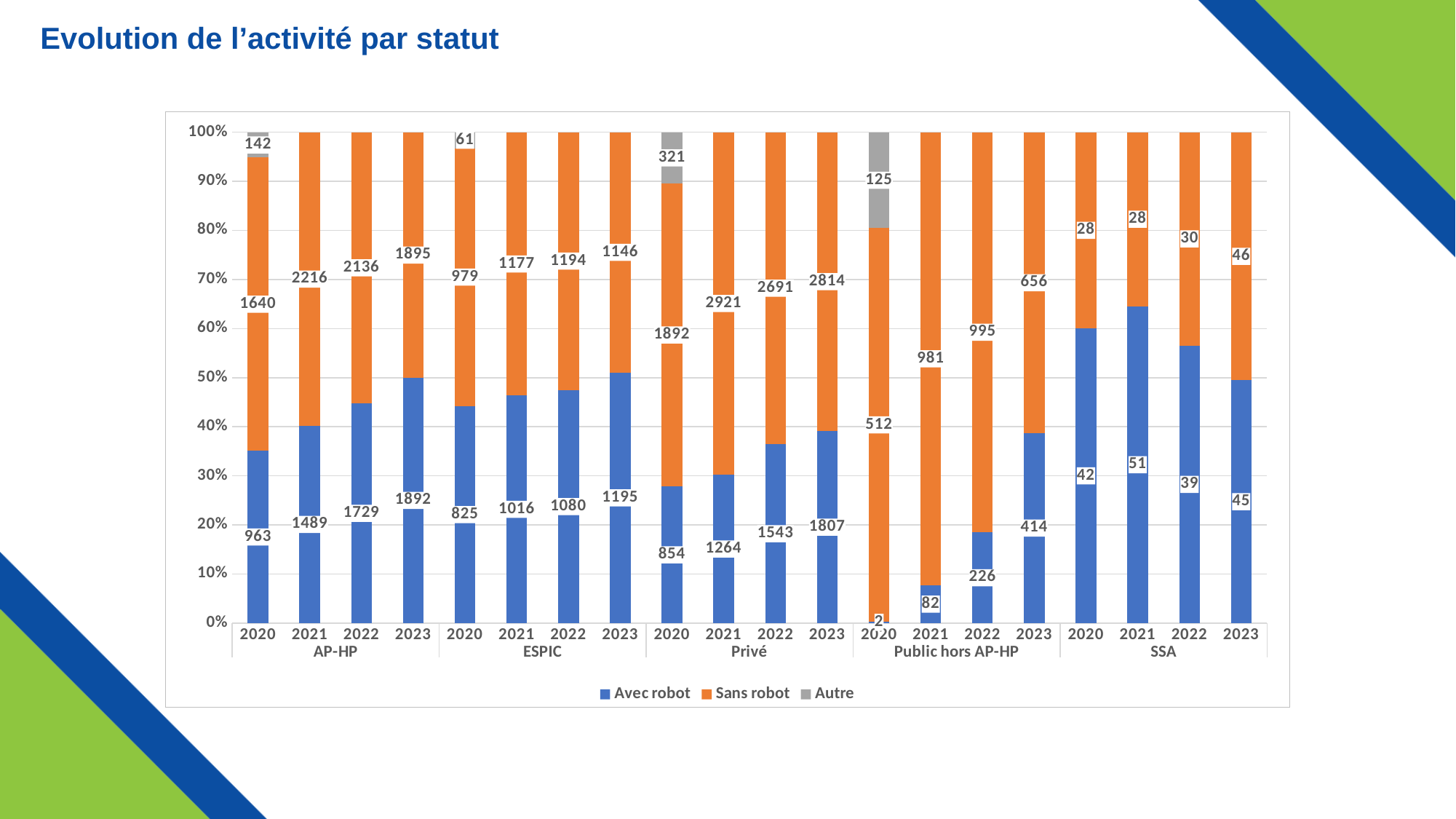
What is the difference between the Sans robot and Avec robot values for ESPIC in 2023? 49 What is the total of the Avec robot and Sans robot values for Privé in 2023? 4621 Does the Avec robot share for AP-HP rise or fall from 2020 to 2023? rise Which is larger for Public hors AP-HP in 2022: the Avec robot value or the Sans robot value? Sans robot What kind of chart is shown on the slide? Stacked bar chart Is the Avec robot share for SSA in 2021 greater or less than 60%? greater What is the Avec robot value for SSA in 2022? 39 What is the Avec robot value for AP-HP in 2020? 963 What is the total of the three series for AP-HP in 2020? 2745 What is the Autre value for Public hors AP-HP in 2020? 125 What is the Sans robot value for Privé in 2021? 2921 How many series does the legend list? 3